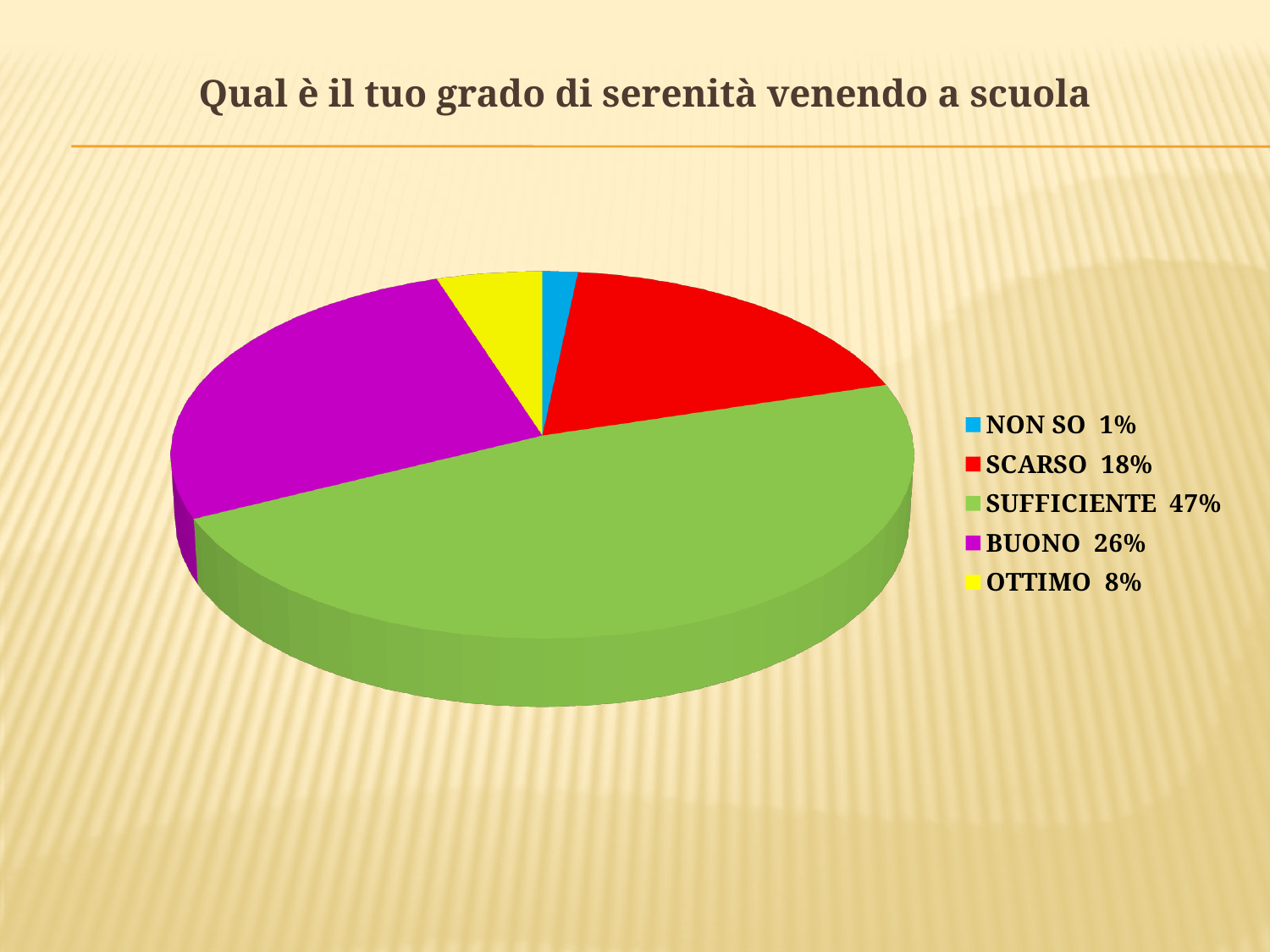
What share of the pie does SUFFICIENTE represent? 47% How many categories does the pie chart have? 5 Which category has the largest slice of the pie? SUFFICIENTE Which is larger, the share for SCARSO or the share for BUONO? BUONO What share of the pie does SCARSO represent? 18% What share of the pie does BUONO represent? 26% What colour is the slice for SUFFICIENTE? green What is the difference in percentage points between SUFFICIENTE and BUONO? 21 Which category has the smallest slice of the pie? NON SO What kind of chart is shown on the slide? pie chart